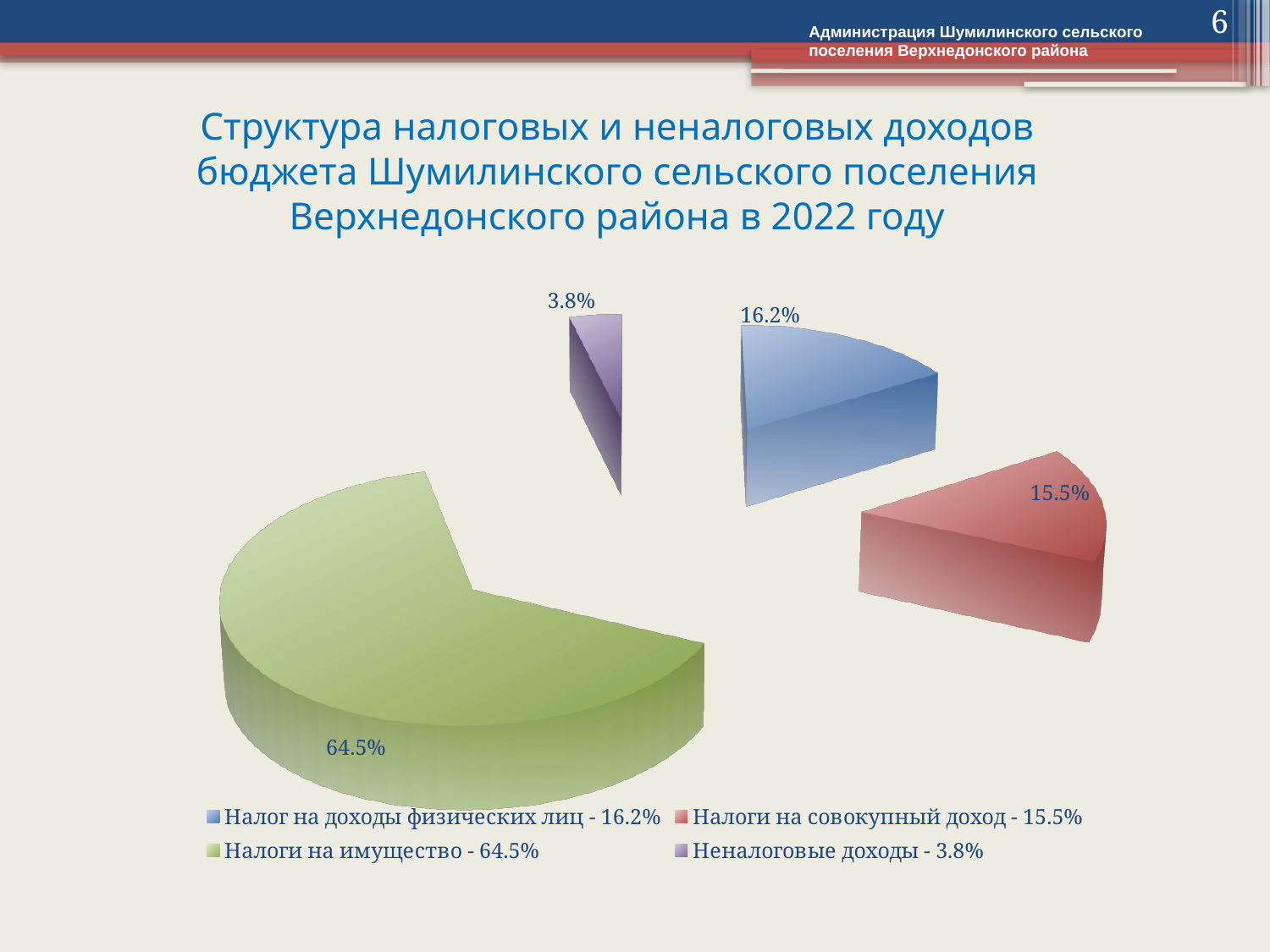
Which category has the smallest slice of the pie? Неналоговые доходы Which is larger: Налог на доходы физических лиц or Неналоговые доходы? Налог на доходы физических лиц What colour is the slice for Налоги на совокупный доход? Red What is the value shown for Неналоговые доходы? 3.8% What is the combined share of Налог на доходы физических лиц and Налоги на совокупный доход? 31.7% How many slices does the pie chart have? 4 What share of the pie does Налоги на имущество represent? 64.5% Which category has the largest slice of the pie? Налоги на имущество What is the value shown for Налоги на совокупный доход? 15.5% What is the difference in percentage points between Налоги на имущество and Налог на доходы физических лиц? 48.3 What type of chart is shown on the slide? Pie chart What is the value shown for Налог на доходы физических лиц? 16.2%